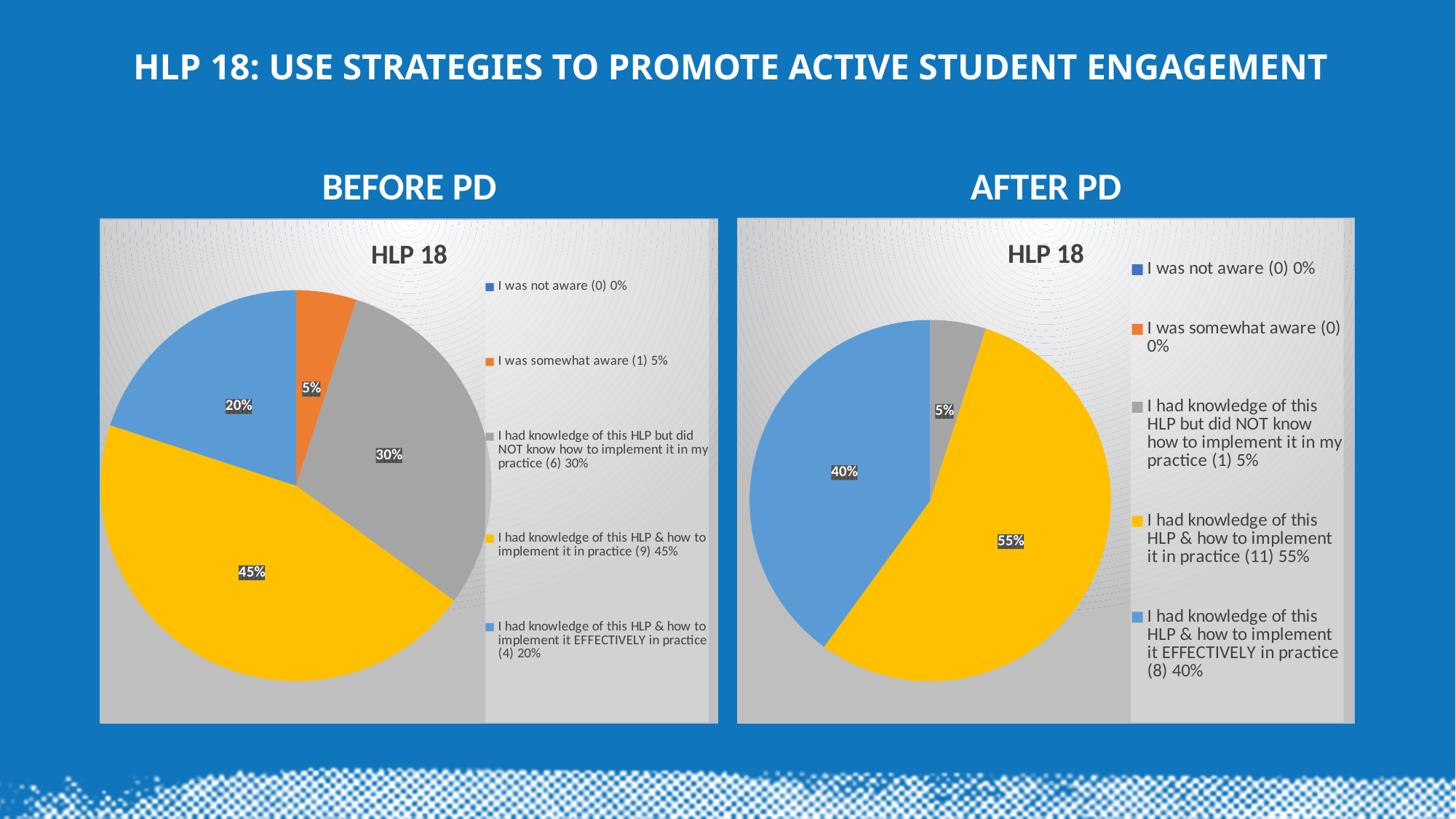
In the AFTER PD chart, how many respondents had knowledge of this HLP & how to implement it in practice? 11 In the AFTER PD chart, which category has the largest share? I had knowledge of this HLP & how to implement it in practice What type of chart is used in the BEFORE PD chart? Pie chart In the BEFORE PD chart, what percentage of respondents were somewhat aware? 5% In the BEFORE PD chart, what percentage of respondents had knowledge of this HLP & how to implement it in practice? 45% In the BEFORE PD chart, which category has the largest share? I had knowledge of this HLP & how to implement it in practice In the BEFORE PD chart, which is larger: the share for 'I had knowledge of this HLP but did NOT know how to implement it in my practice' or the share for 'I had knowledge of this HLP & how to implement it EFFECTIVELY in practice'? I had knowledge of this HLP but did NOT know how to implement it in my practice In the AFTER PD chart, what percentage of respondents had knowledge of this HLP & how to implement it EFFECTIVELY in practice? 40% What is the difference between the 'I had knowledge of this HLP & how to implement it EFFECTIVELY in practice' share in the AFTER PD chart and in the BEFORE PD chart? 20% What colour represents 'I had knowledge of this HLP & how to implement it in practice' in the BEFORE PD chart? Yellow How many categories does the legend of the AFTER PD chart list? 5 In the AFTER PD chart, what percentage had knowledge of this HLP but did NOT know how to implement it in practice? 5%